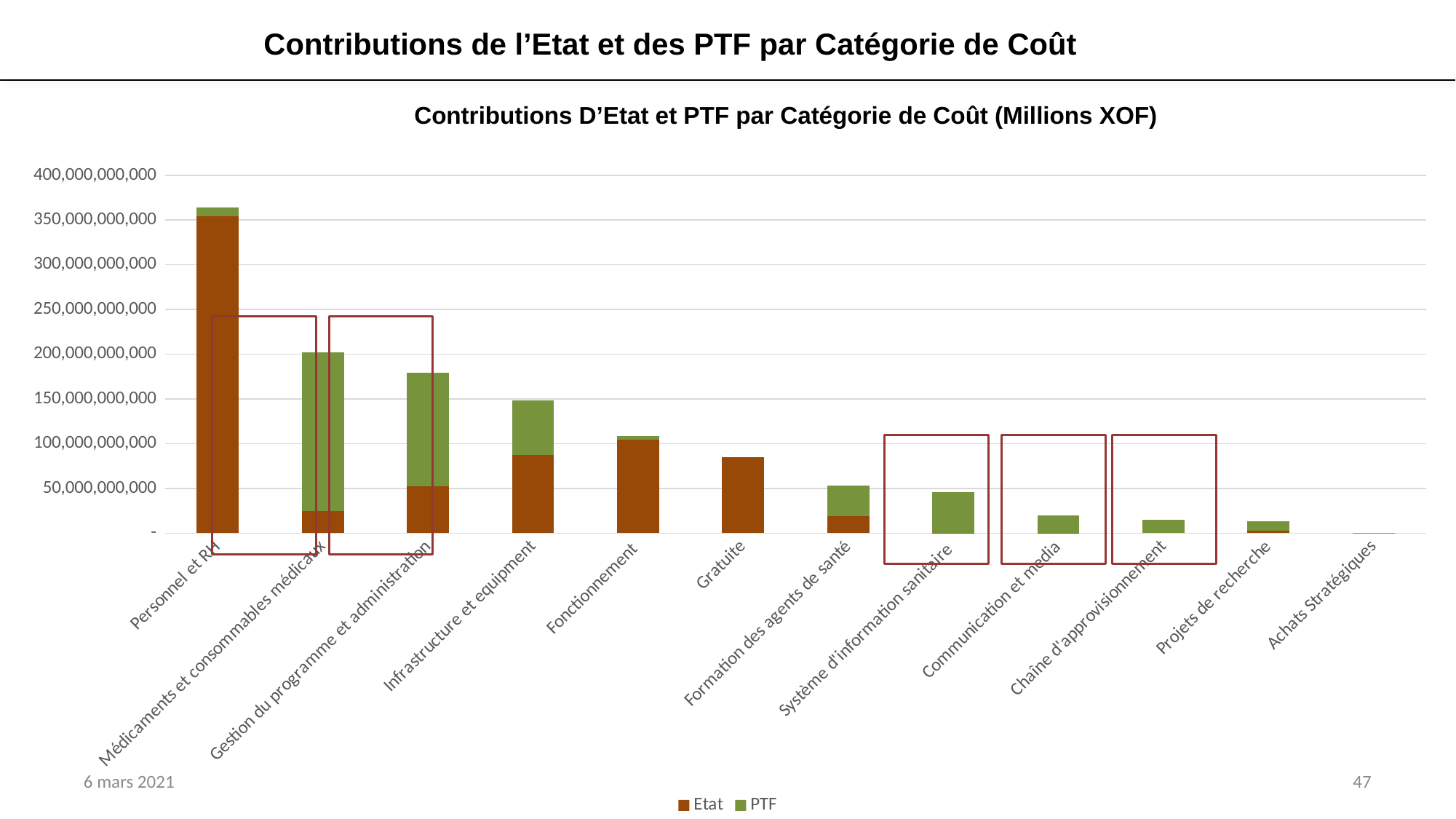
Is the total bar for Communication et media greater or less than 50,000,000,000? less How many series does the chart legend list? 2 Which series is shown in green in the chart legend? PTF Is the total bar for Gratuite greater or less than 100,000,000,000? less What kind of chart is shown on the slide? Stacked bar chart Which has the larger total bar, Médicaments et consommables médicaux or Gestion du programme et administration? Médicaments et consommables médicaux Which cost category has the highest total bar? Personnel et RH Do the total bar heights generally rise or fall moving from left to right along the x axis? Fall How many cost categories are shown on the x axis of the chart? 12 Which cost category has the lowest total bar? Achats Stratégiques Is the total bar for Gestion du programme et administration greater or less than 200,000,000,000? less